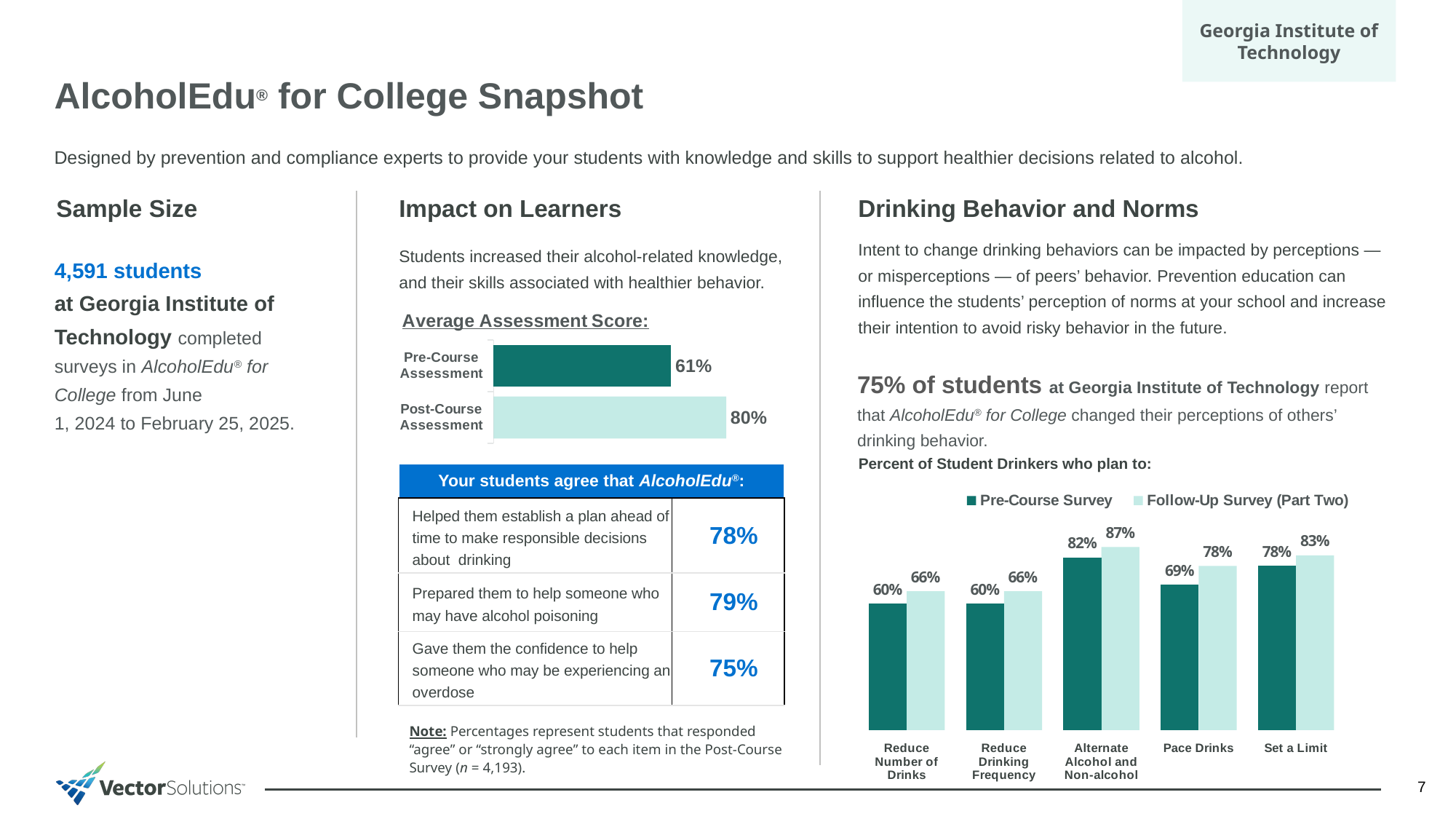
In the Percent of Student Drinkers who plan to chart, what is the Pre-Course Survey value for Alternate Alcohol and Non-alcohol? 82% In the Percent of Student Drinkers who plan to chart, what is the Follow-Up Survey (Part Two) value for Pace Drinks? 78% In the Percent of Student Drinkers who plan to chart, what is the difference between the Follow-Up Survey and Pre-Course Survey values for Pace Drinks? 9% In the Average Assessment Score chart, what is the difference between the Post-Course and Pre-Course Assessment scores? 19% In the Percent of Student Drinkers who plan to chart, which category has the highest Follow-Up Survey (Part Two) value? Alternate Alcohol and Non-alcohol In the Percent of Student Drinkers who plan to chart, how many categories are shown on the x axis? 5 In the Average Assessment Score chart, what is the Post-Course Assessment score? 80% In the Percent of Student Drinkers who plan to chart, how many series does the legend list? 2 In the Percent of Student Drinkers who plan to chart, which is larger: the Pre-Course Survey value for Set a Limit or the Pre-Course Survey value for Pace Drinks? Set a Limit In the Percent of Student Drinkers who plan to chart, what are the two series named in the legend? Pre-Course Survey and Follow-Up Survey (Part Two) In the Average Assessment Score chart, what is the Pre-Course Assessment score? 61% What kind of chart is the Average Assessment Score chart? Bar chart